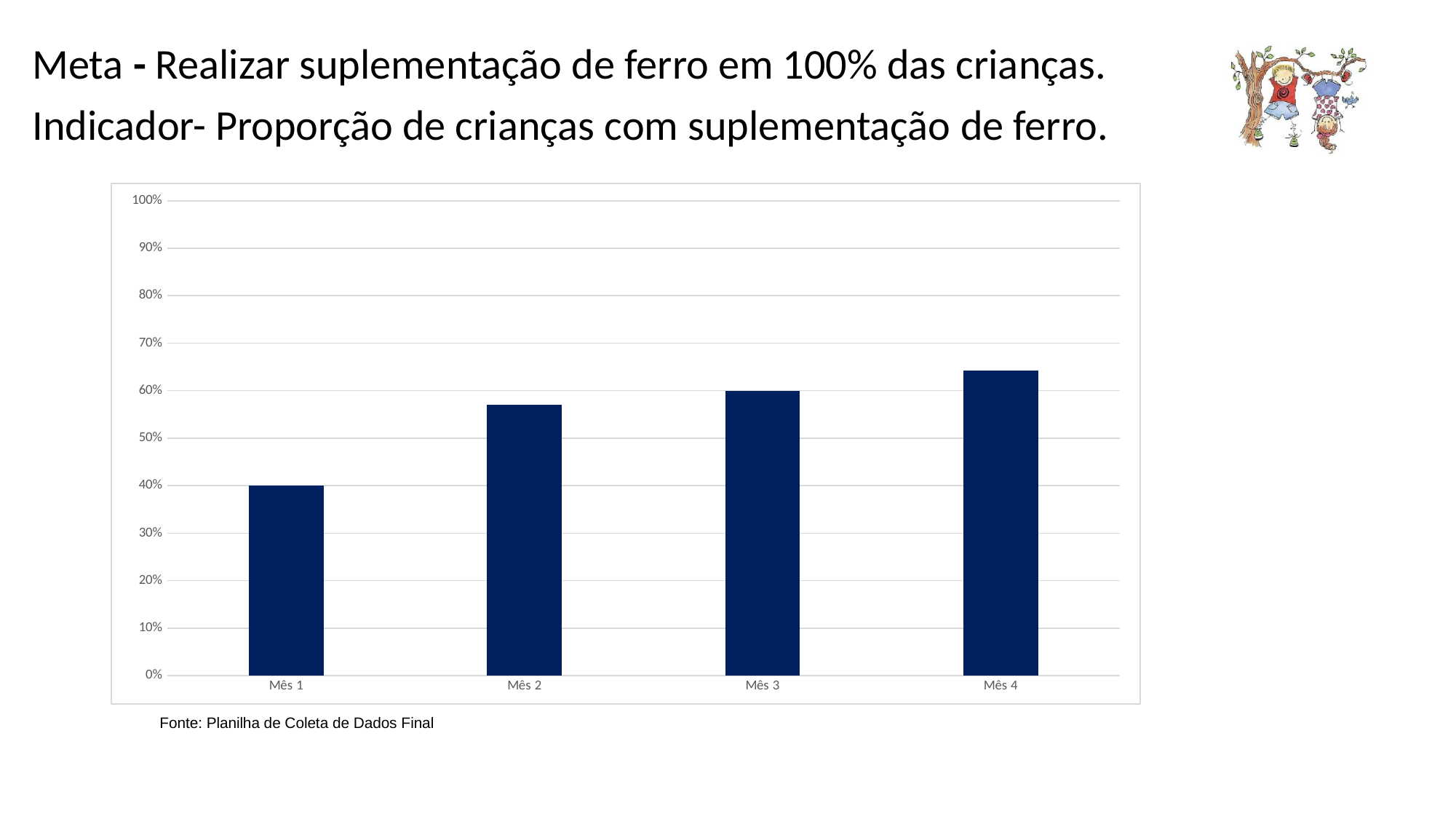
Which month has the highest proportion of children with iron supplementation? Mês 4 How many categories (months) are plotted on the x axis? 4 What kind of chart is shown on the slide? bar chart Is the value for Mês 3 greater or less than 50%? greater What is the value for Mês 1? 40% Which month has the lowest proportion of children with iron supplementation? Mês 1 Is the value for Mês 4 greater or less than 70%? less Which is larger, the value for Mês 2 or the value for Mês 4? Mês 4 Is the value for Mês 2 greater or less than 50%? greater Do the values rise or fall from Mês 1 to Mês 4? rise Which is larger, the value for Mês 1 or the value for Mês 3? Mês 3 What source is cited below the chart? Fonte: Planilha de Coleta de Dados Final